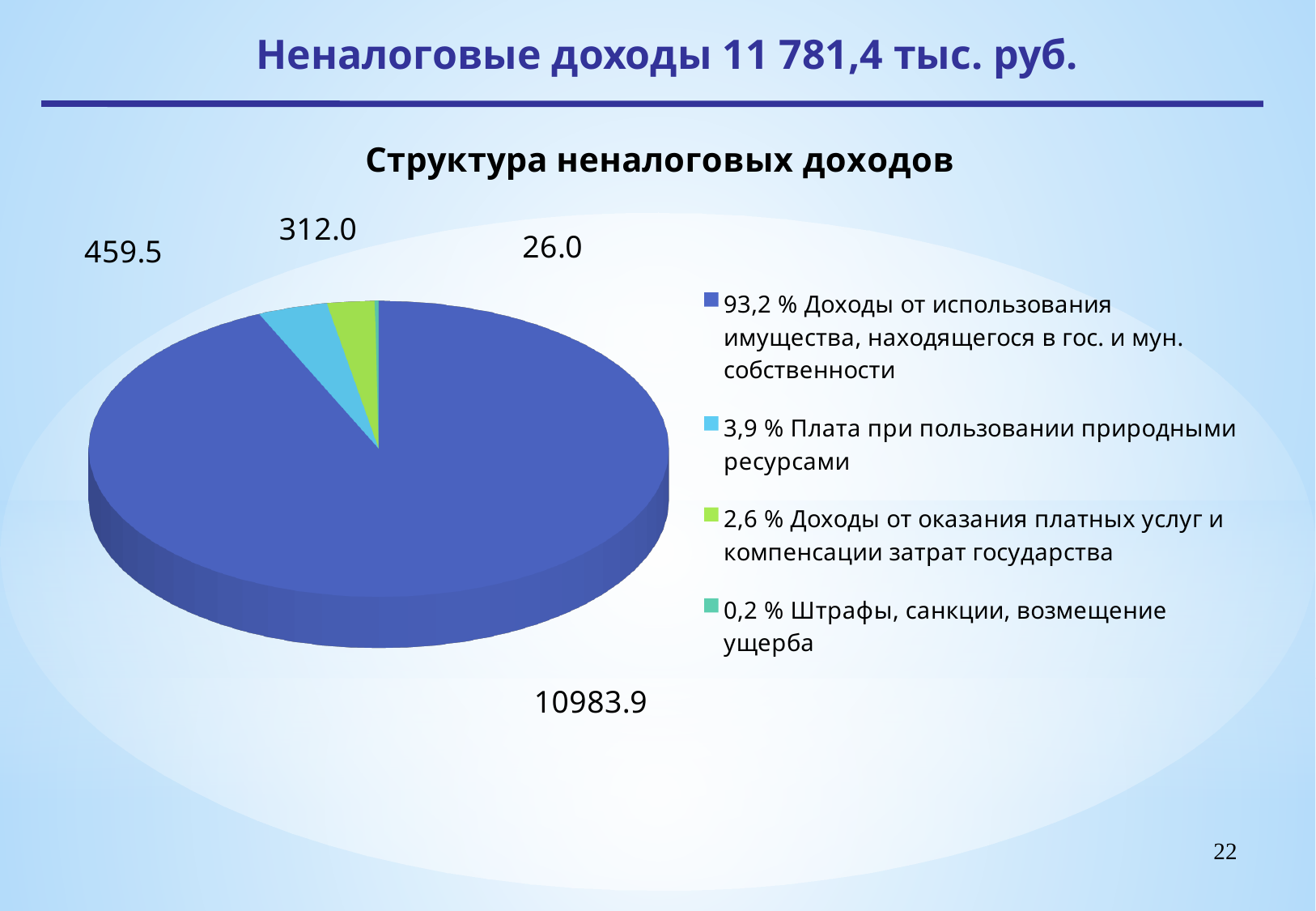
What is the value for Плата при пользовании природными ресурсами? 459.5 Which category has the smallest slice of the pie? Штрафы, санкции, возмещение ущерба Which is larger: the value for Доходы от оказания платных услуг и компенсации затрат государства or the value for Штрафы, санкции, возмещение ущерба? Доходы от оказания платных услуг и компенсации затрат государства What share of the pie does Плата при пользовании природными ресурсами represent? 3,9 % What kind of chart is shown on the slide? pie chart How many slices does the pie chart have? 4 What is the value for Доходы от оказания платных услуг и компенсации затрат государства? 312.0 Which category has the largest slice of the pie? Доходы от использования имущества, находящегося в гос. и мун. собственности What is the value for Доходы от использования имущества, находящегося в гос. и мун. собственности? 10983.9 What is the value for Штрафы, санкции, возмещение ущерба? 26.0 What is the difference between the values for Плата при пользовании природными ресурсами and Доходы от оказания платных услуг и компенсации затрат государства? 147.5 What is the title of the chart? Структура неналоговых доходов